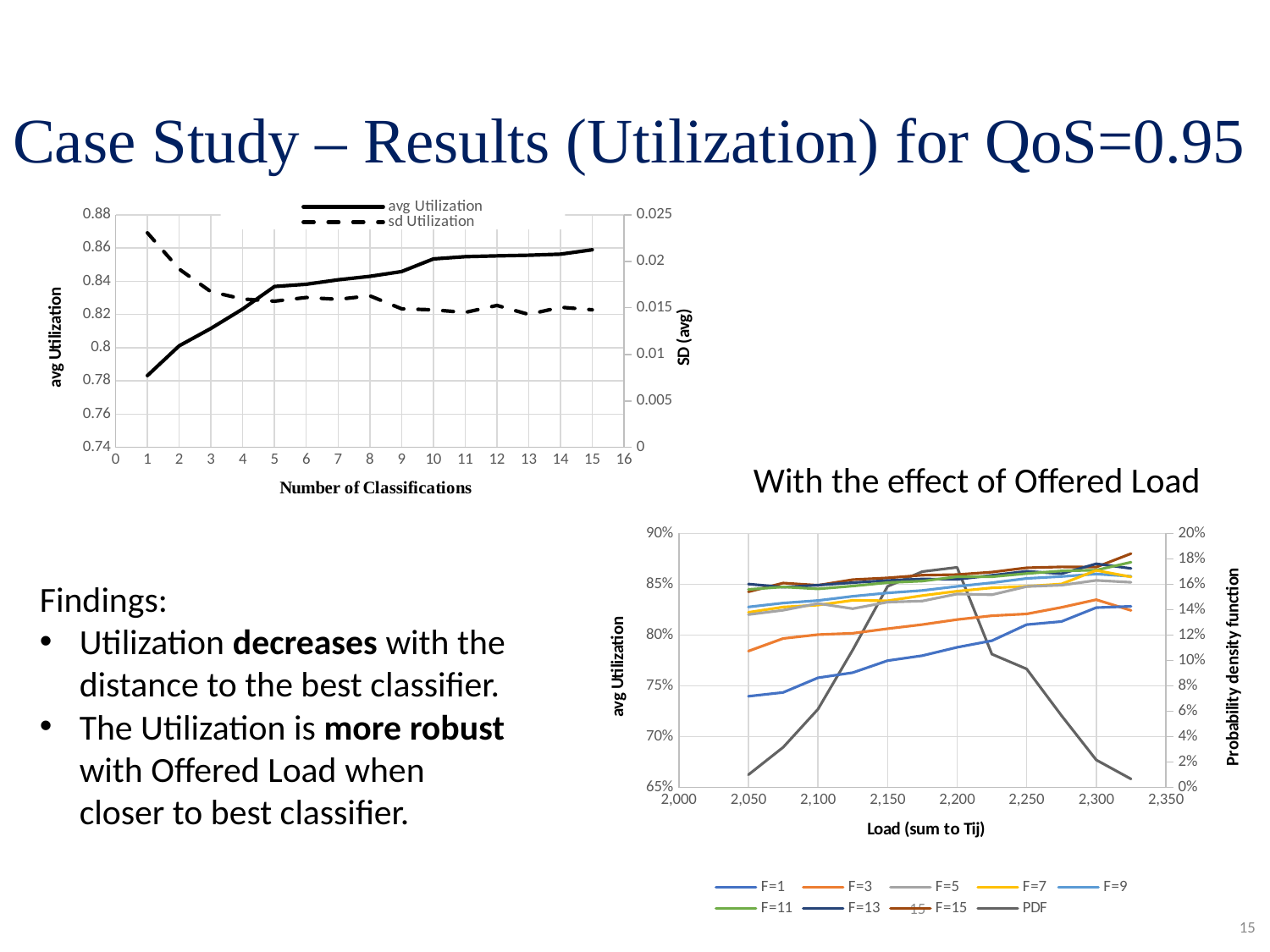
In the top-left chart, does avg Utilization rise or fall as the Number of Classifications increases? rise In the top-left chart, does sd Utilization rise or fall as the Number of Classifications increases? fall In the bottom-right chart, at a load of 2,050, which has the higher avg Utilization, F=1 or F=15? F=15 In the top-left chart, is the avg Utilization at 15 classifications greater or less than 0.84? greater In the top-left chart, is the sd Utilization at 1 classification greater or less than 0.02? greater In the top-left chart, is the avg Utilization at 1 classification greater or less than 0.8? less In the bottom-right chart, which series has the lowest avg Utilization at a load of 2,050? F=1 In the top-left chart, what kind of chart is used to plot avg Utilization and sd Utilization? line chart In the bottom-right chart, how many series does the legend list? 9 In the bottom-right chart, what is the title of the x axis? Load (sum to Tij) In the top-left chart, how many series does the legend list? 2